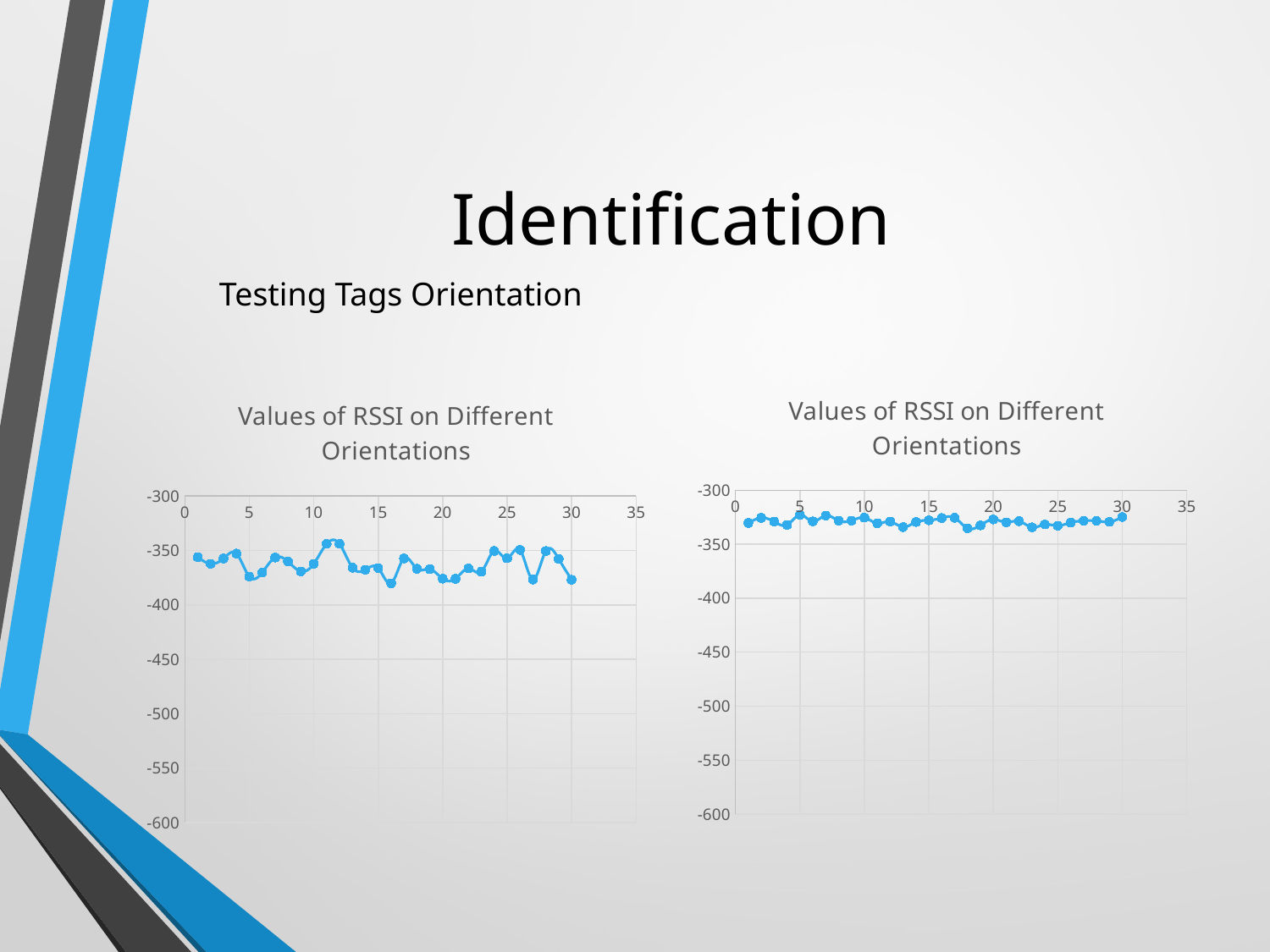
What is the lowest tick shown on the y axis of the right chart? -600 In the left chart, which is larger, the value at x = 12 or the value at x = 16? x = 12 In the right chart, is the value at x = 5 greater or less than -350? greater What is the title of the left chart? Values of RSSI on Different Orientations What kind of chart is the right chart on the slide? line chart In the left chart, is the value at x = 12 greater or less than -350? greater In the right chart, which is larger, the value at x = 5 or the value at x = 18? x = 5 In the left chart, are all plotted values greater or less than -400? greater What kind of chart is the left chart on the slide? line chart